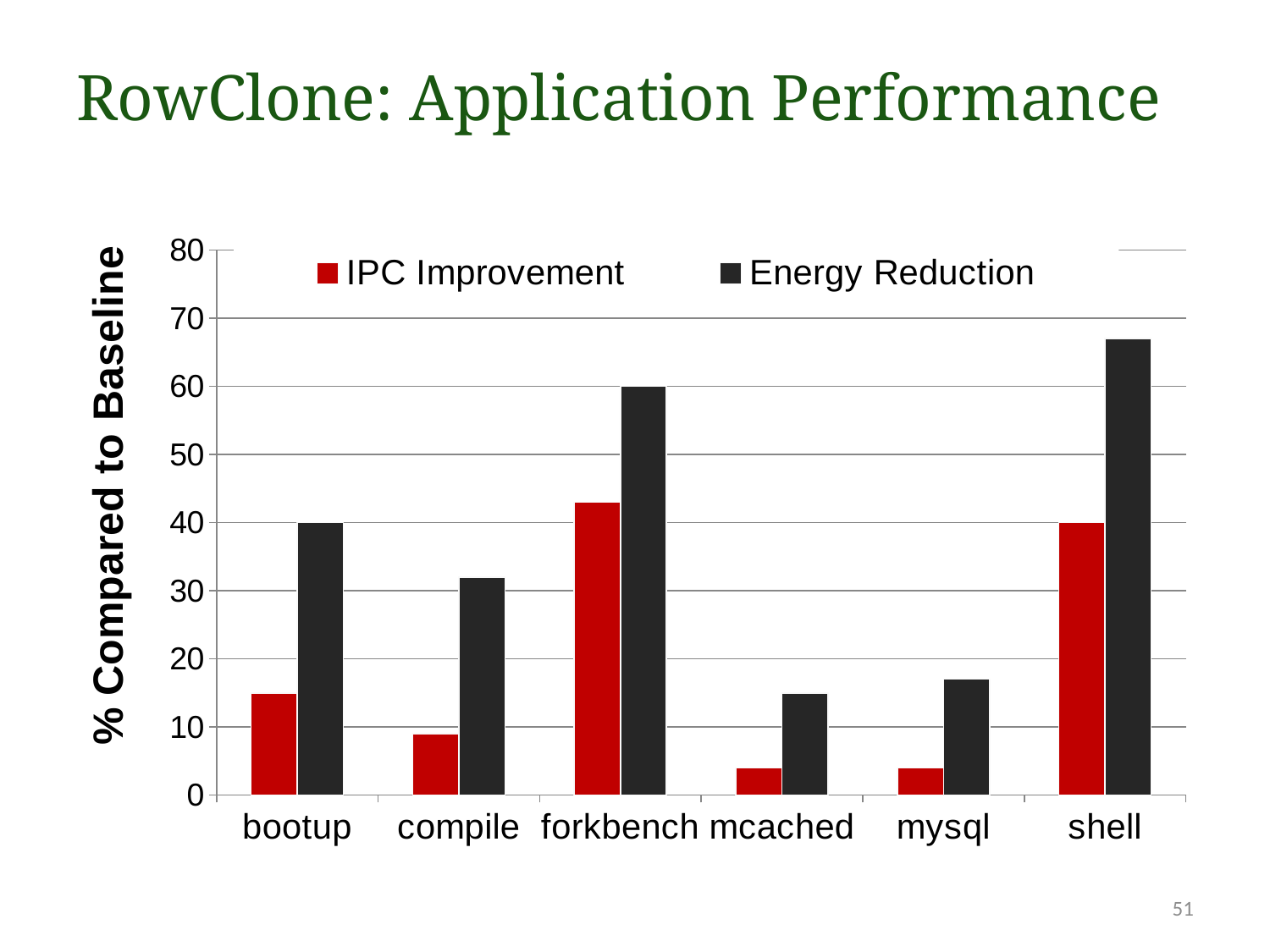
What is the label on the y axis? % Compared to Baseline How many series does the legend list? 2 Is the Energy Reduction for compile greater or less than 30? greater How many applications are shown on the x axis? 6 What kind of chart is shown on the slide? bar chart Which application has the lowest Energy Reduction? mcached Which application has the highest Energy Reduction? shell Is the Energy Reduction for mysql greater or less than 20? less Which application has the highest IPC Improvement? forkbench Which is larger, the Energy Reduction for bootup or the Energy Reduction for compile? bootup What is the Energy Reduction for bootup? 40 Is the IPC Improvement for forkbench greater or less than 40? greater